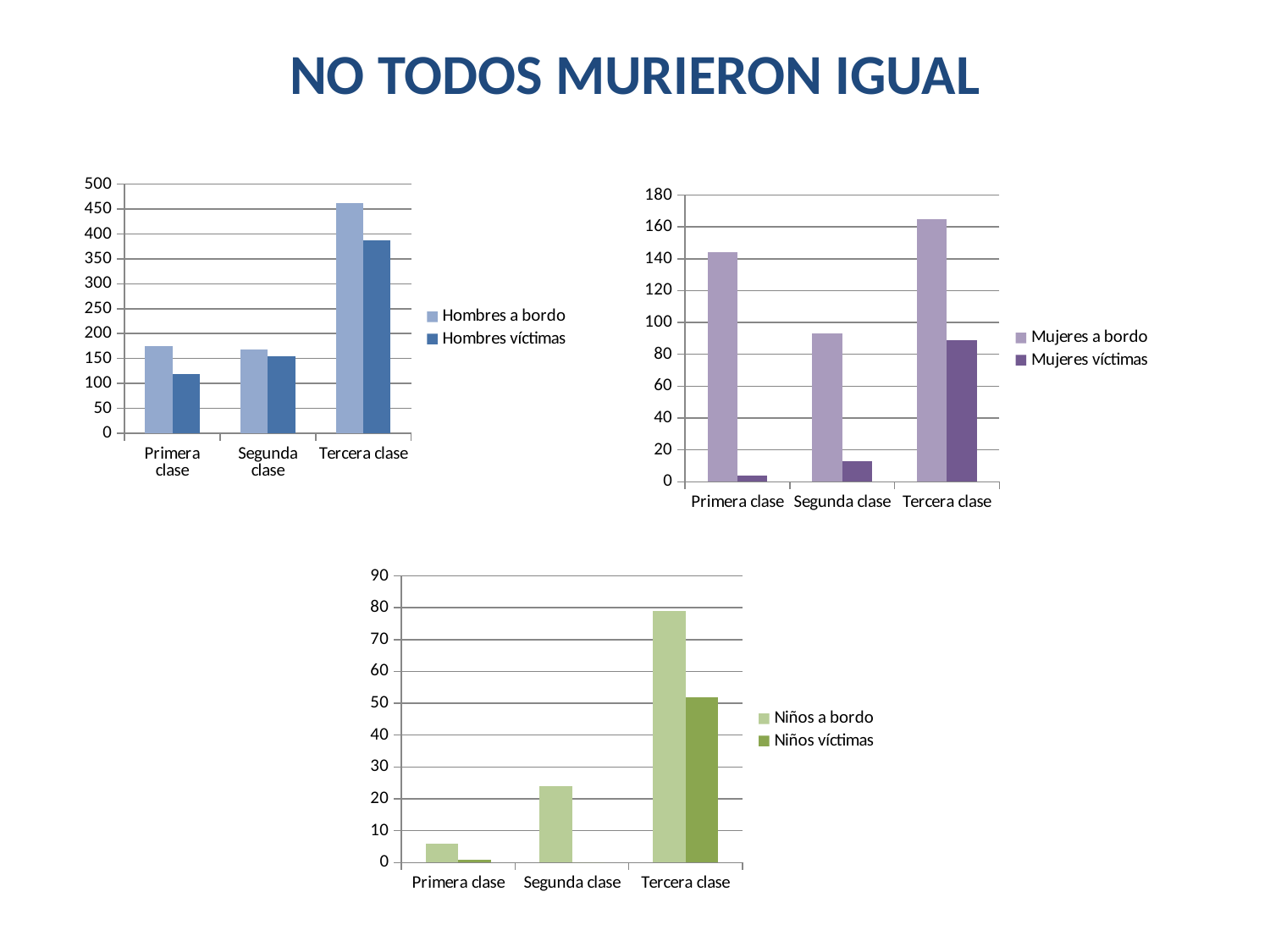
In the bottom chart (Niños), is the value for Niños a bordo in Tercera clase greater or less than 70? greater In the top-left chart (Hombres), which is larger: Hombres víctimas in Segunda clase or Hombres víctimas in Primera clase? Segunda clase In the top-right chart (Mujeres), which is larger for Tercera clase: Mujeres a bordo or Mujeres víctimas? Mujeres a bordo In the top-right chart (Mujeres), which category has the lowest value for Mujeres víctimas? Primera clase How many series does the legend of the top-right chart (Mujeres) list? 2 What kind of chart is the top-left chart (Hombres)? bar chart In the top-left chart (Hombres), is the value for Hombres víctimas in Primera clase greater or less than 150? less How many categories are shown on the x axis of the bottom chart (Niños)? 3 In the top-right chart (Mujeres), is the value for Mujeres a bordo in Segunda clase greater or less than 100? less In the bottom chart (Niños), do the values for Niños a bordo rise or fall from Primera clase to Tercera clase? rise What is the title of the slide? NO TODOS MURIERON IGUAL In the top-left chart (Hombres), which category has the highest value for Hombres a bordo? Tercera clase